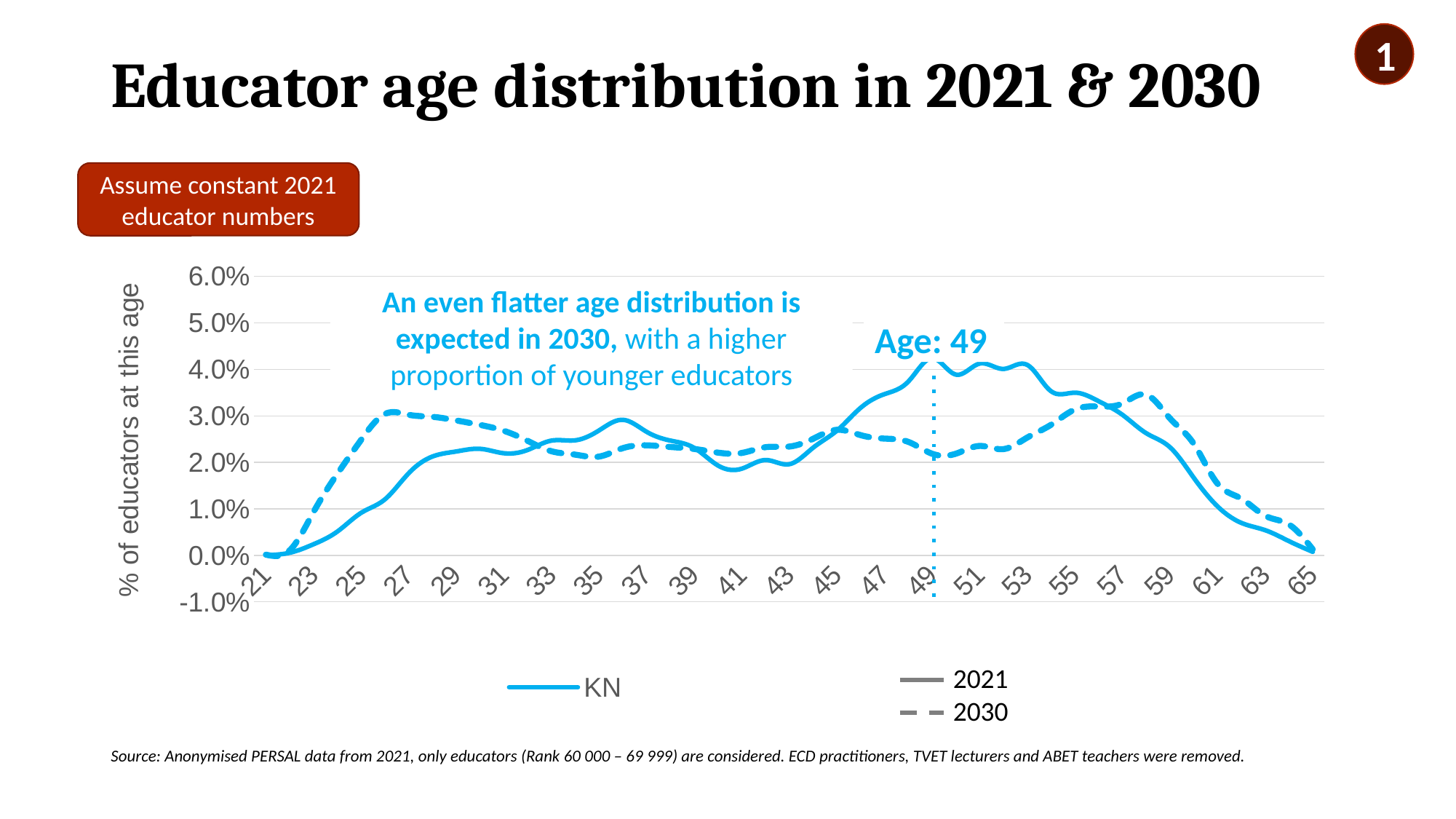
Is the 2030 value at age 41 greater or less than 2.0%? greater At age 27, which series has the larger value, 2021 or 2030? 2030 Is the 2021 value at age 53 greater or less than 3.0%? greater Does the 2021 series rise or fall between age 53 and age 65? fall What is the label on the chart's vertical axis? % of educators at this age Which two series are shown in the chart's legend? 2021 and 2030 Is the 2021 value at age 23 greater or less than 1.0%? less At age 59, which series has the larger value, 2021 or 2030? 2030 At age 49, which series has the larger value, 2021 or 2030? 2021 How many series does the chart's legend list? 2 What kind of chart is shown on the slide? line chart